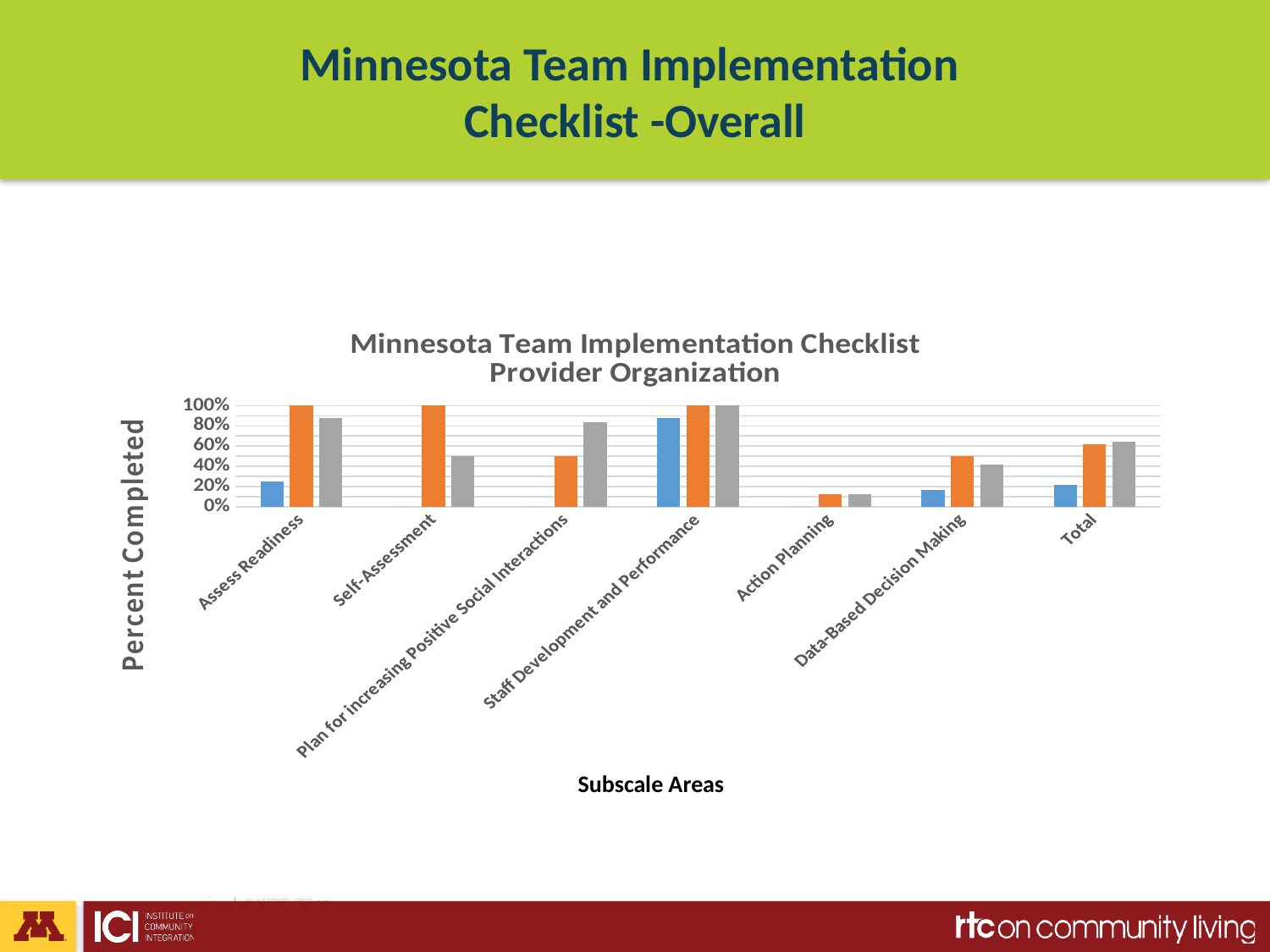
What is the value of the gray bar for Staff Development and Performance? 100% What is the label on the vertical axis of the chart? Percent Completed Is the value of the orange bar for Action Planning greater or less than 20%? less How many subscale area categories are shown on the x axis of the chart? 7 What is the value of the orange bar for Self-Assessment? 100% Is the value of the gray bar for Plan for Increasing Positive Social Interactions greater or less than 60%? greater Is the value of the blue bar for Assess Readiness greater or less than 40%? less Which is larger for Self-Assessment, the orange bar or the gray bar? the orange bar How many bars (series) are plotted for the Staff Development and Performance category? 3 What is the value of the orange bar for Assess Readiness? 100% Which category has the lowest orange bar? Action Planning What kind of chart is shown on the slide? bar chart